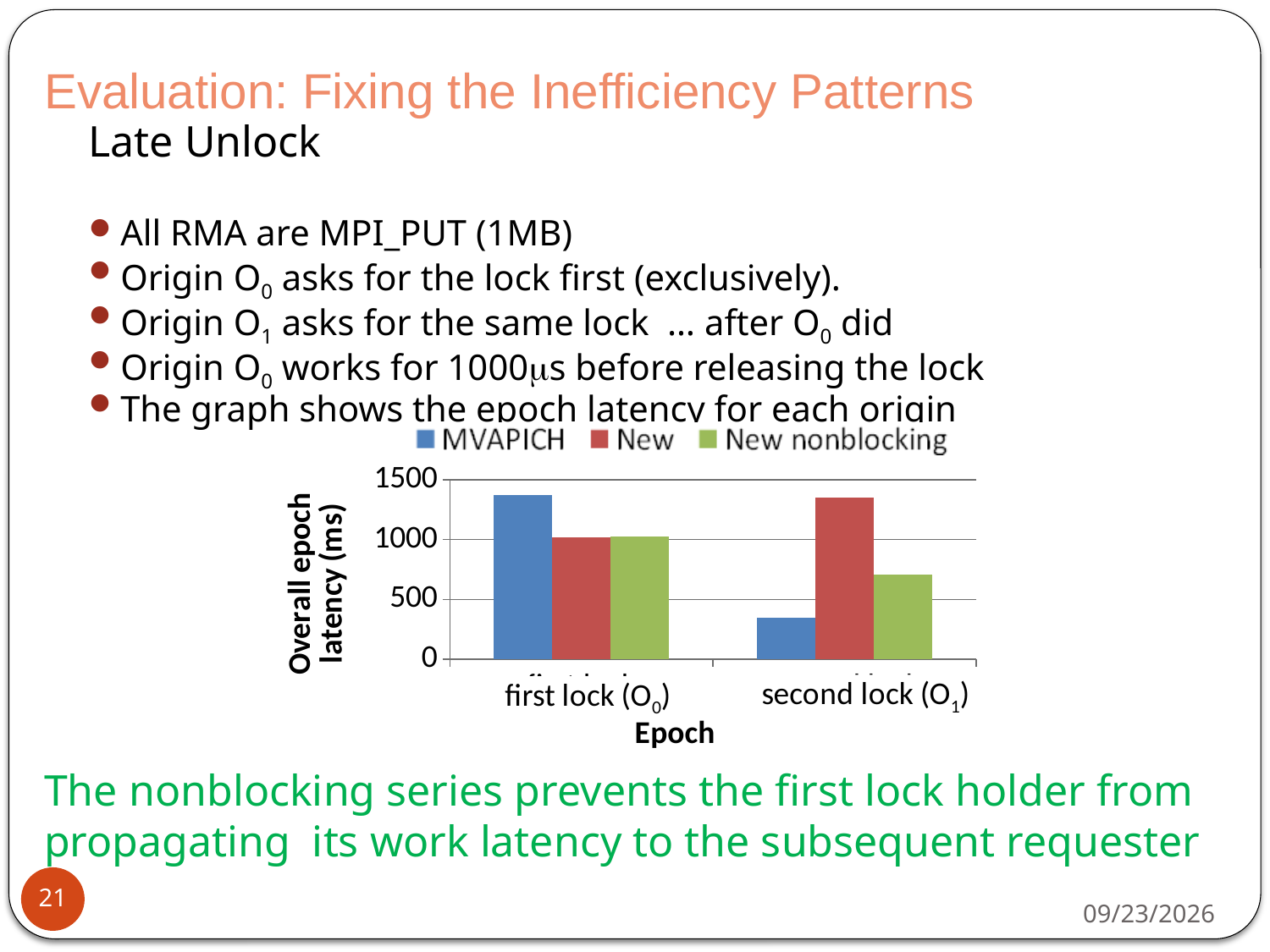
For the second lock (O1), which is larger: the New value or the New nonblocking value? New Does the MVAPICH series rise or fall from the first lock (O0) to the second lock (O1)? fall Which series has the highest overall epoch latency for the second lock (O1)? New How many categories are shown on the x axis of the chart? 2 How many series does the chart's legend list? 3 Which series has the lowest overall epoch latency for the second lock (O1)? MVAPICH What kind of chart is shown on the slide? bar chart Is the MVAPICH value for the first lock (O0) greater or less than 1000? greater Is the MVAPICH value for the second lock (O1) greater or less than 500? less What is the label of the chart's y axis? Overall epoch latency (ms) Which series has the highest overall epoch latency for the first lock (O0)? MVAPICH Is the New nonblocking value for the second lock (O1) greater or less than 1000? less